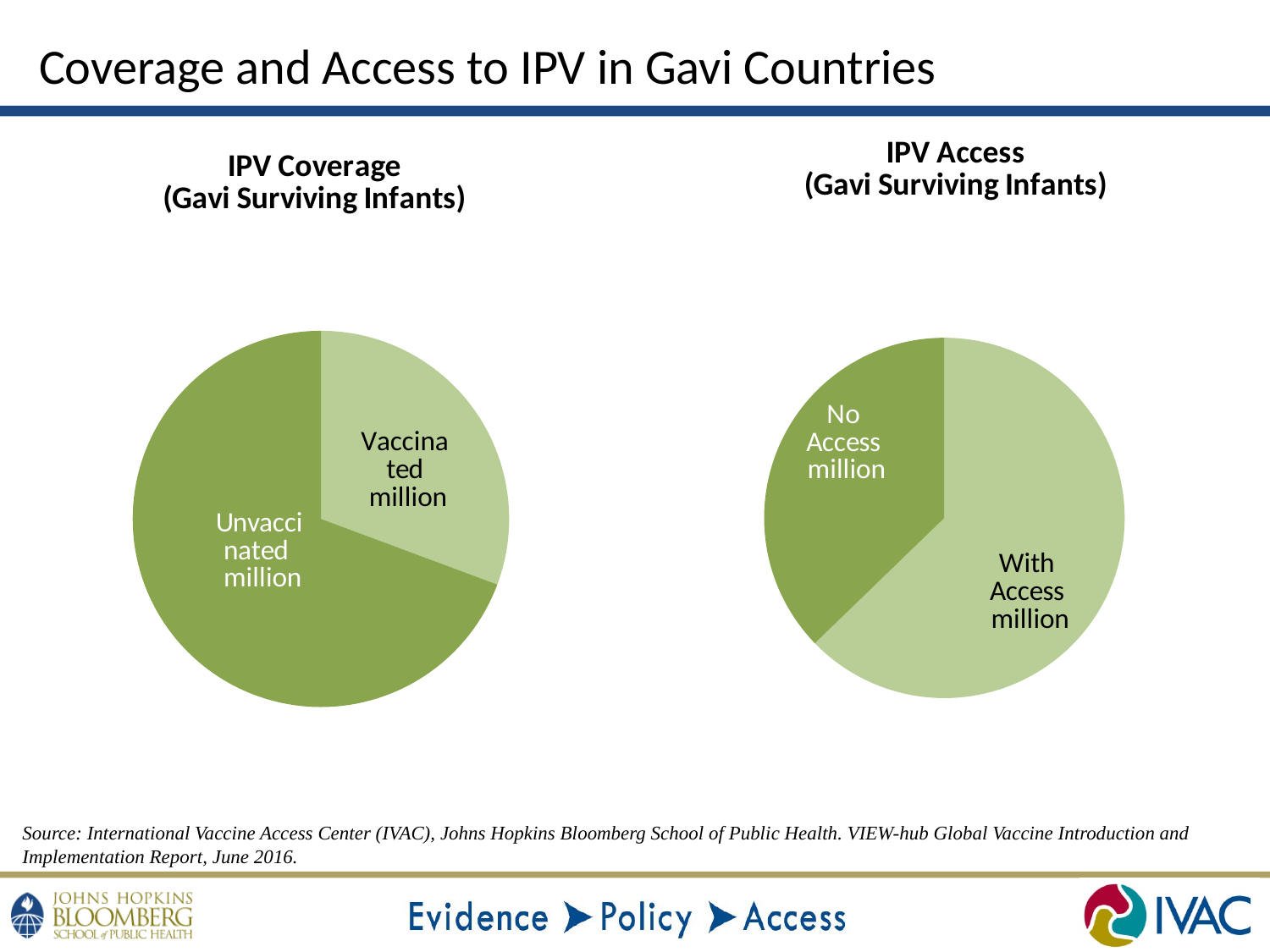
In the IPV Access (Gavi Surviving Infants) chart, how many slices does the pie have? 2 In the IPV Access (Gavi Surviving Infants) chart, which category has the largest slice? With Access In the IPV Coverage (Gavi Surviving Infants) chart, which slice is larger, Vaccinated or Unvaccinated? Unvaccinated In the IPV Access (Gavi Surviving Infants) chart, which slice is larger, With Access or No Access? With Access What is the title of the pie chart on the right of the slide? IPV Access (Gavi Surviving Infants) What kind of chart is the IPV Coverage (Gavi Surviving Infants) chart on the left? Pie chart In the IPV Coverage (Gavi Surviving Infants) chart, which category has the smallest slice? Vaccinated What is the title of the pie chart on the left of the slide? IPV Coverage (Gavi Surviving Infants) In the IPV Coverage (Gavi Surviving Infants) chart, how many slices does the pie have? 2 What kind of chart is the IPV Access (Gavi Surviving Infants) chart on the right? Pie chart In the IPV Coverage (Gavi Surviving Infants) chart, which category has the largest slice? Unvaccinated In the IPV Access (Gavi Surviving Infants) chart, which category has the smallest slice? No Access